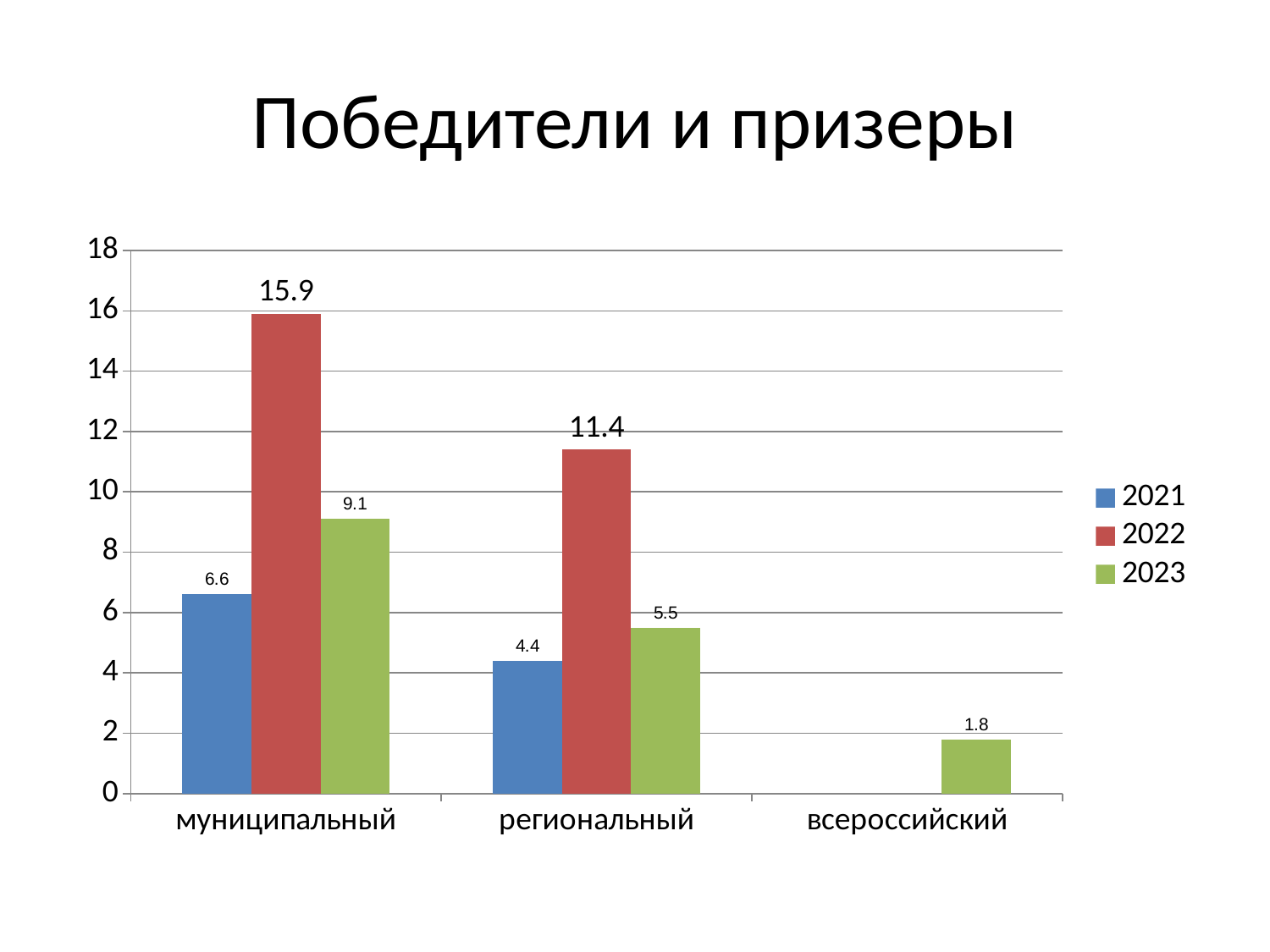
What is the value for 2022 in the муниципальный category? 15.9 Which is larger in the региональный category: the 2023 value or the 2021 value? 2023 Is the value for 2023 in the муниципальный category greater or less than 8? greater How many categories are shown on the x axis? 3 How many series does the legend list? 3 What is the title of the chart? Победители и призеры What is the value for 2023 in the всероссийский category? 1.8 Which category has the highest value for the 2022 series? муниципальный What is the difference between the 2022 and 2021 values in the муниципальный category? 9.3 What kind of chart is shown on the slide? bar chart What is the value for 2021 in the региональный category? 4.4 Which category has the lowest value for the 2023 series? всероссийский